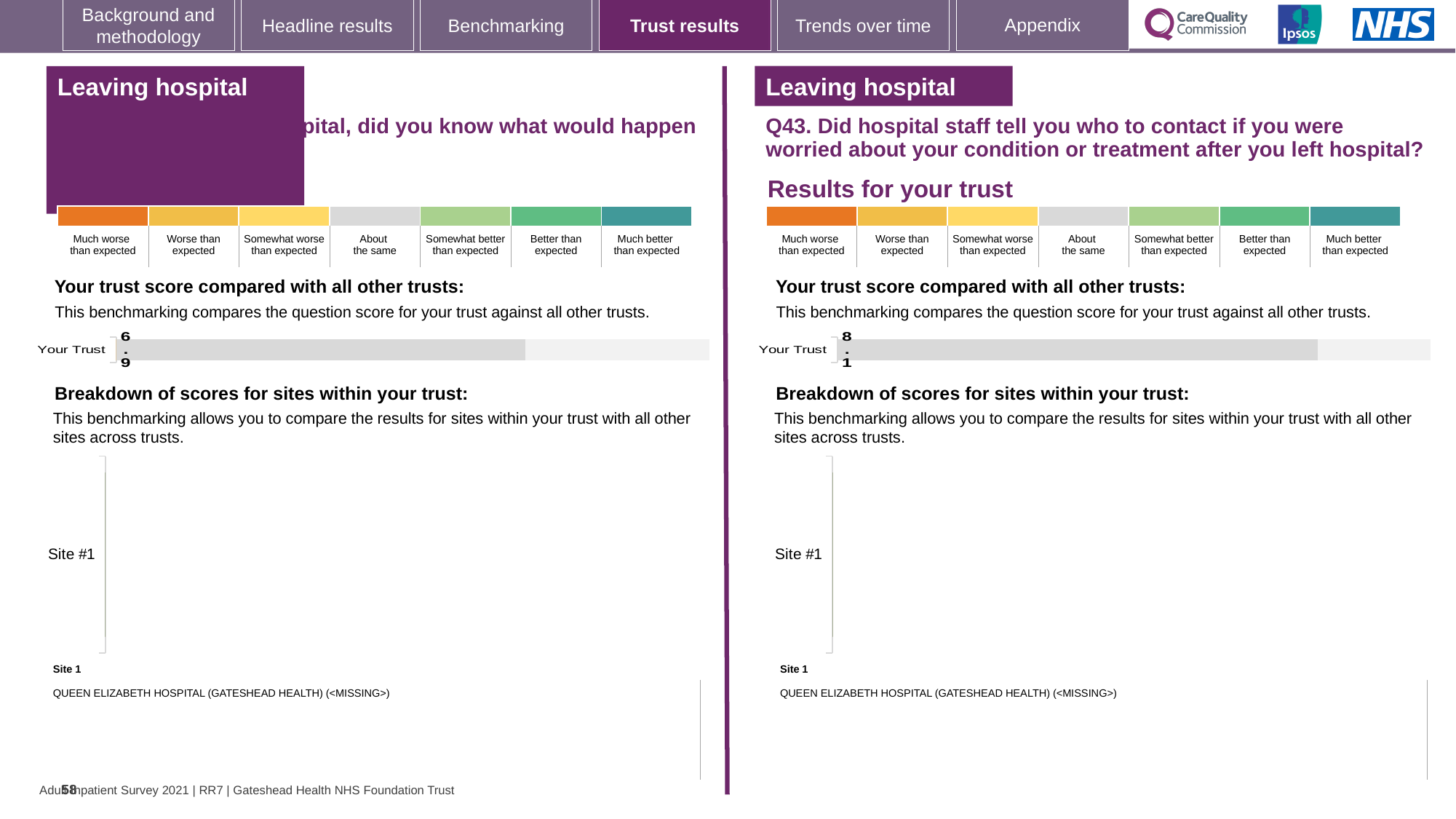
On the left panel's 'Your trust score compared with all other trusts' chart, what is the value shown for Your Trust? 6.9 On the right panel's (Q43) 'Your trust score compared with all other trusts' chart, what is the value shown for Your Trust? 8.1 What is the category label shown on the right panel's (Q43) 'Breakdown of scores for sites within your trust' chart? Site #1 Which panel's 'Your Trust' score is larger, the left panel or the right panel (Q43)? Right panel (Q43) What kind of chart is used to show the Your Trust score on the right panel (Q43)? Bar chart How many categories are plotted on the left panel's 'Your trust score compared with all other trusts' chart? 1 How many categories are shown on the left panel's 'Breakdown of scores for sites within your trust' chart? 1 What is the category label on the right panel's (Q43) trust score chart? Your Trust What is the difference between the right panel's (Q43) Your Trust score and the left panel's Your Trust score? 1.2